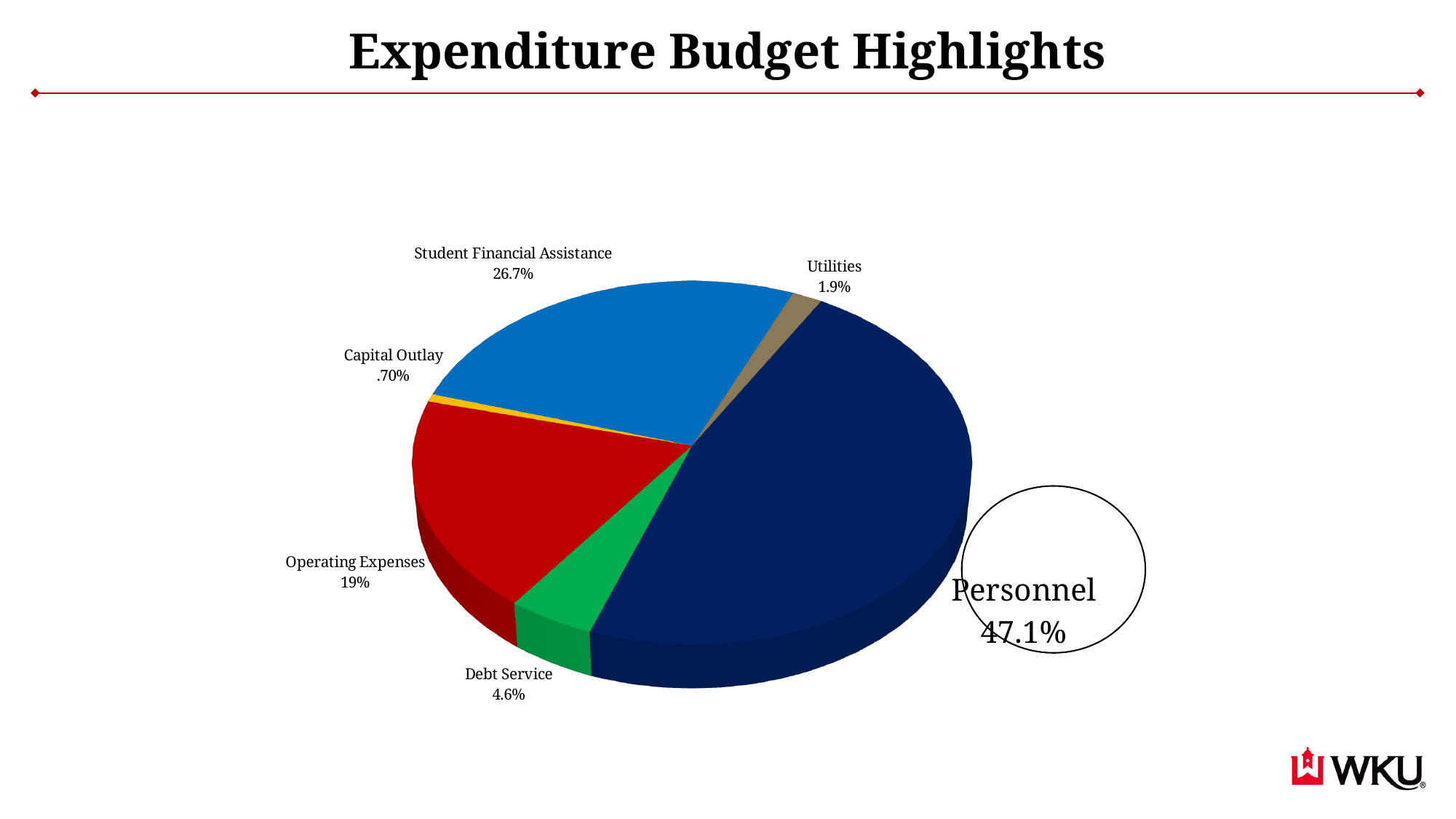
Which category has the smallest slice of the pie? Capital Outlay What is the value shown for Utilities? 1.9% Which category has the largest slice of the pie? Personnel What share of the expenditure budget goes to Personnel? 47.1% What percentage of the pie is Student Financial Assistance? 26.7% What is the title of the slide containing the chart? Expenditure Budget Highlights What type of chart is shown on the slide? Pie chart What is the value shown for Operating Expenses? 19% How many categories are shown in the pie chart? 6 Which is larger, Student Financial Assistance or Operating Expenses? Student Financial Assistance What percentage is labelled for Debt Service? 4.6% What is the value shown for Capital Outlay? .70%